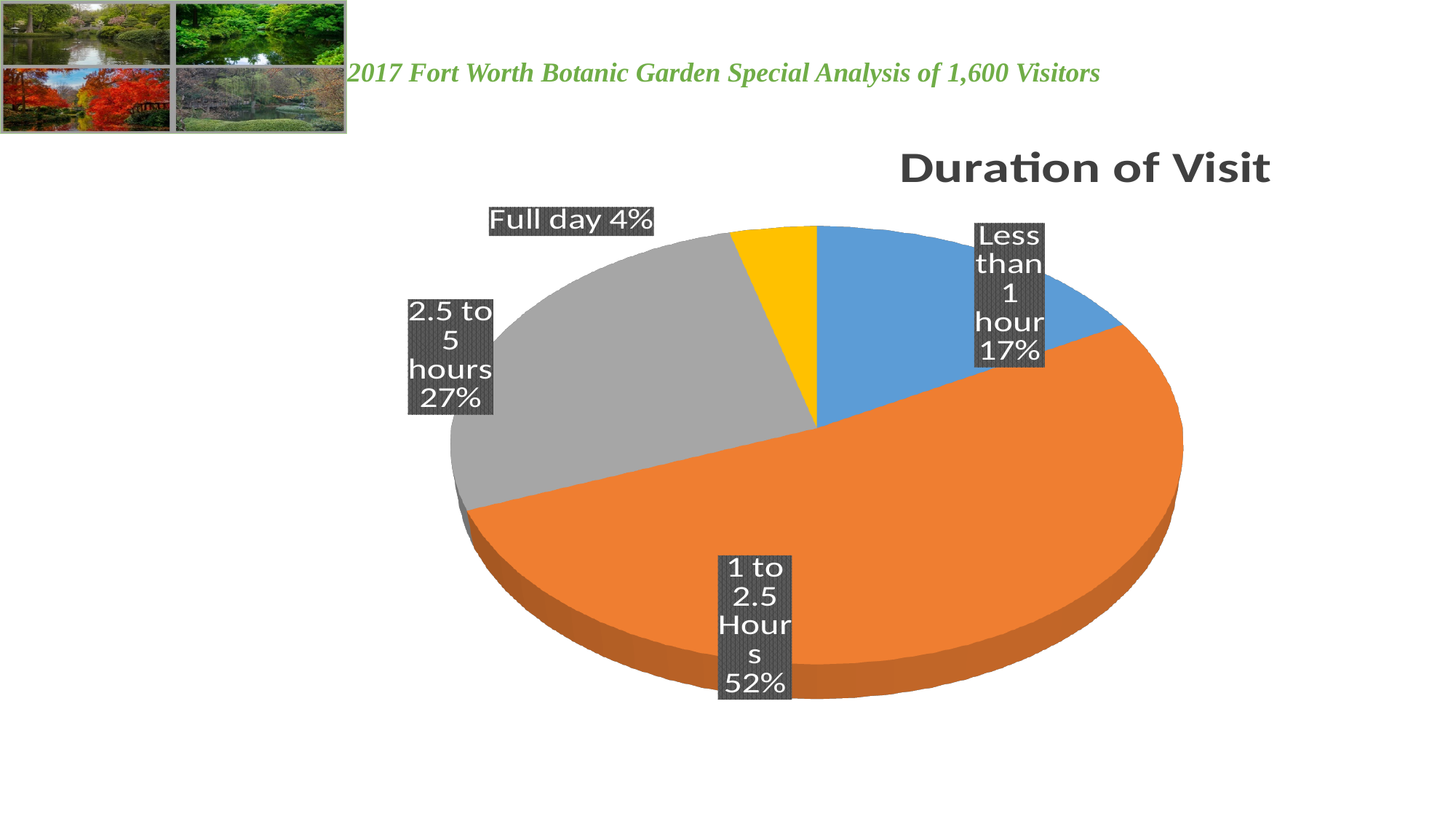
What share of visitors stayed less than 1 hour? 17% How many slices does the pie chart have? 4 What colour is the slice for 1 to 2.5 Hours? orange Which is larger: the share for Less than 1 hour or the share for 2.5 to 5 hours? 2.5 to 5 hours What share of visitors stayed 2.5 to 5 hours? 27% What share of visitors stayed a full day? 4% What is the difference in percentage points between the 1 to 2.5 Hours slice and the 2.5 to 5 hours slice? 25 What kind of chart is shown on the slide? pie chart Which visit duration has the largest share of visitors? 1 to 2.5 Hours What share of visitors stayed 1 to 2.5 hours? 52% Which visit duration has the smallest share of visitors? Full day What is the title of the chart? Duration of Visit